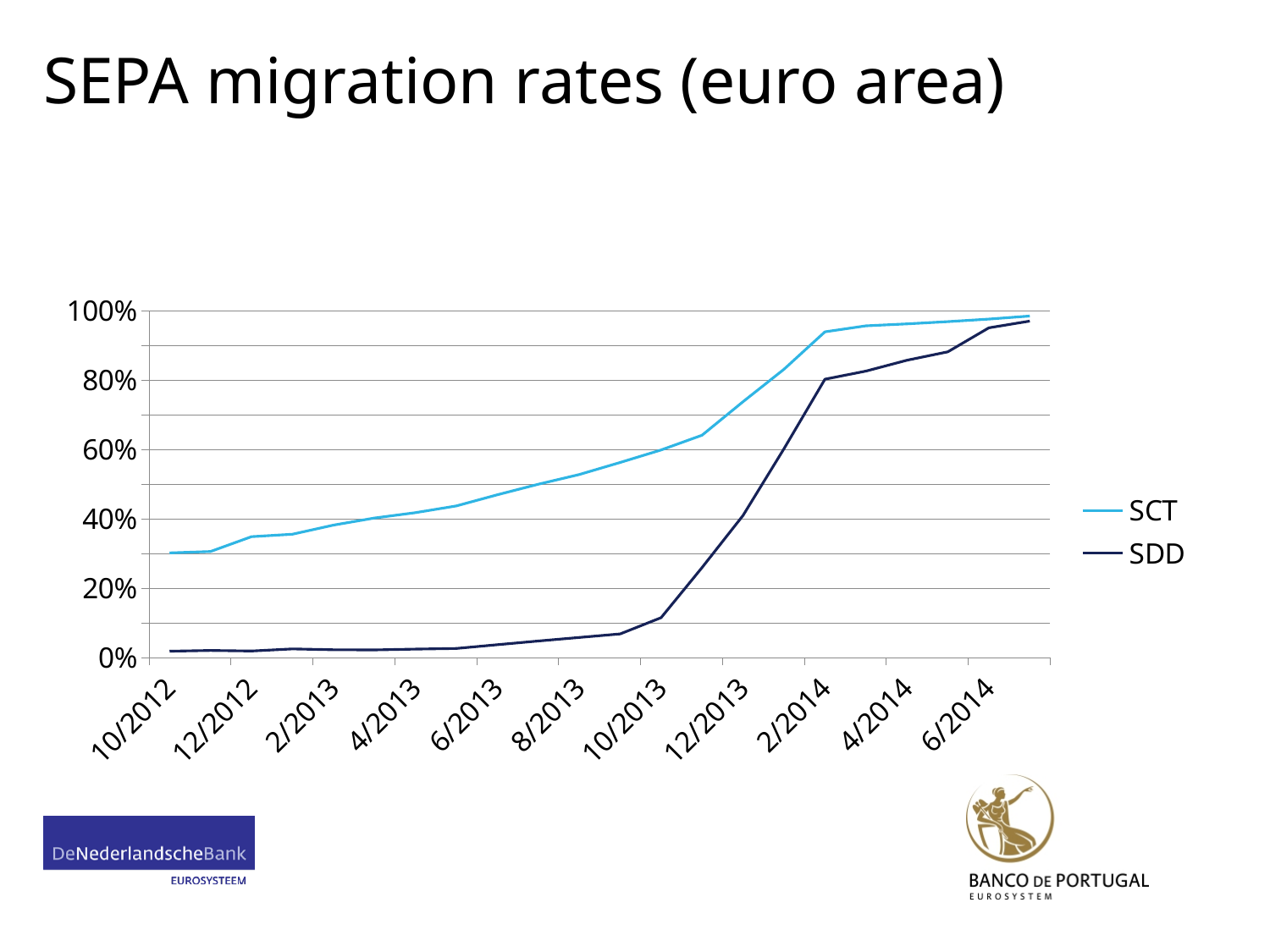
At 10/2013, which series has the larger value, SCT or SDD? SCT Is the value for SCT at 10/2012 greater or less than 20%? greater Is the value for SDD at 10/2012 greater or less than 20%? less What are the names of the two series in the legend? SCT and SDD Is the value for SCT at 8/2013 greater or less than 40%? greater What is the title of the chart? SEPA migration rates (euro area) What kind of chart is shown on the slide? line chart Do the SDD values rise or fall from 10/2012 to 6/2014? rise How many series does the legend list? 2 How many date labels are shown on the x axis? 11